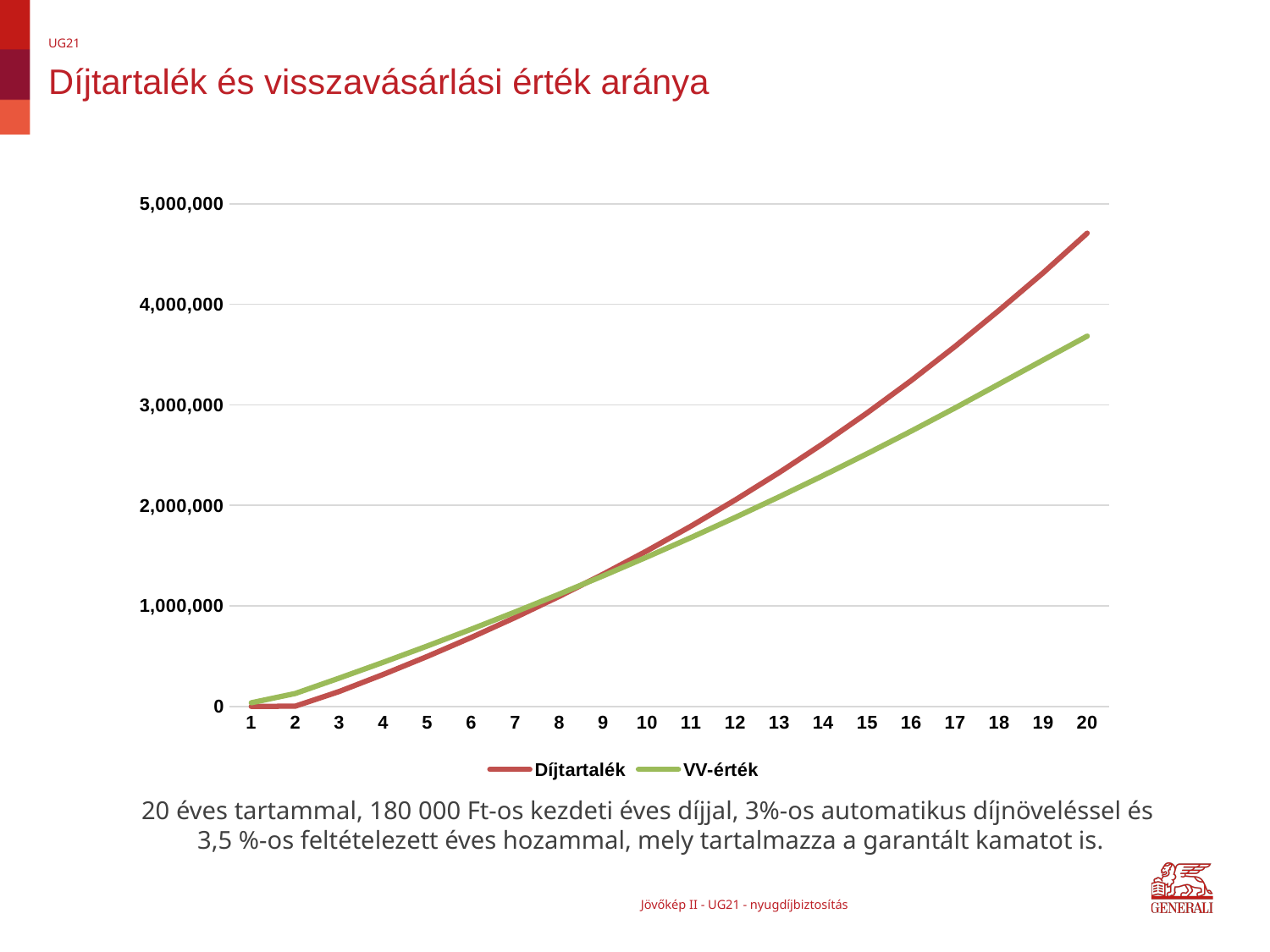
What kind of chart is shown on the slide? line chart Is the value for VV-érték at year 5 greater or less than 1,000,000? less At year 20, which series has the larger value, Díjtartalék or VV-érték? Díjtartalék Do the values of the Díjtartalék series rise or fall from year 1 to year 20? rise Is the value for Díjtartalék at year 13 greater or less than 2,000,000? greater Is the value for VV-érték at year 20 greater or less than 4,000,000? less At year 5, which series has the larger value, Díjtartalék or VV-érték? VV-érték How many points are plotted along the x axis for each series? 20 How many series does the legend list? 2 What is the title of the chart? Díjtartalék és visszavásárlási érték aránya Which series is drawn in green? VV-érték